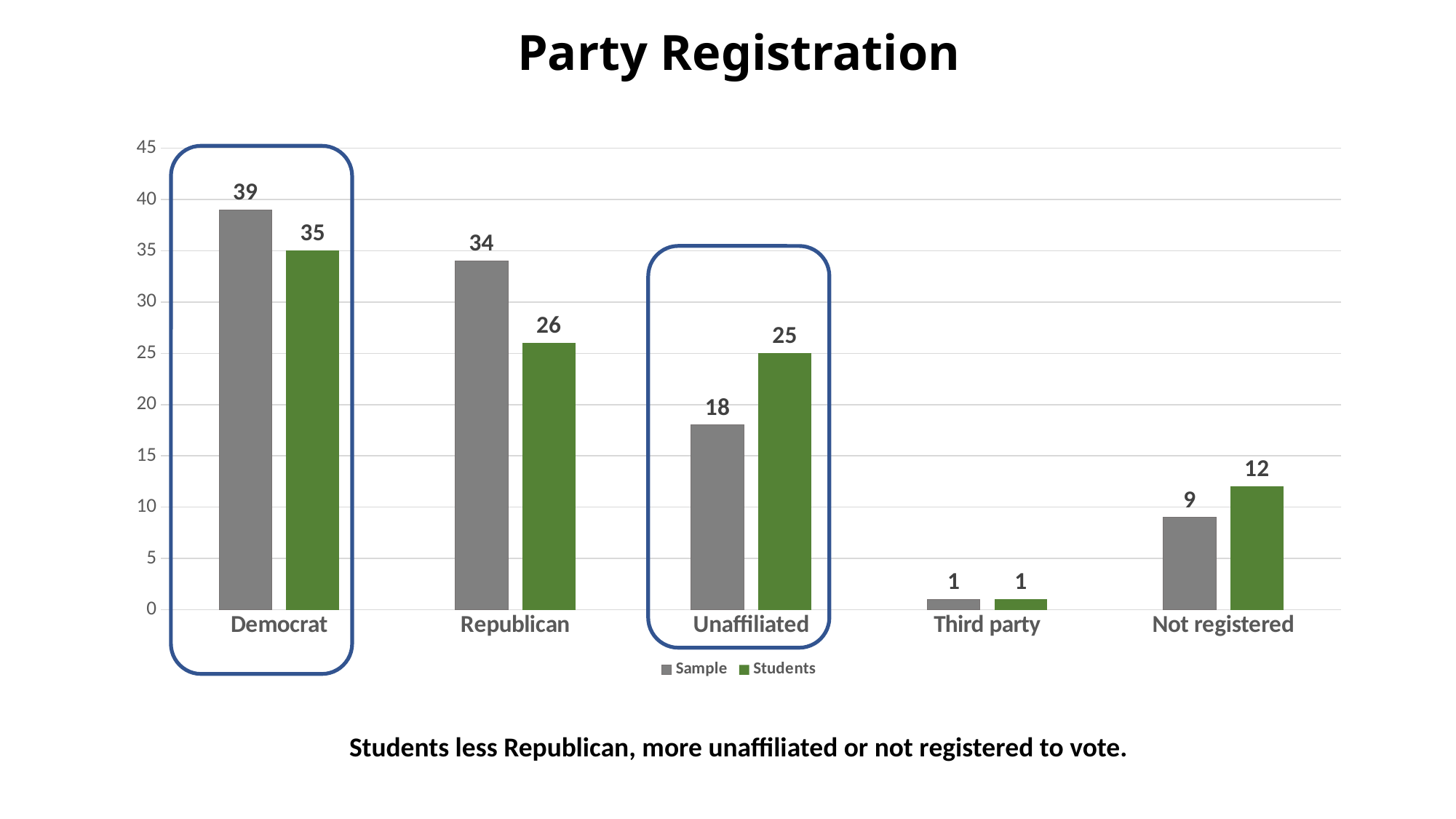
What kind of chart is shown on the slide? Bar chart How many series does the legend list? 2 How many categories are shown on the x axis? 5 What is the difference between the Sample and Students values for Republican? 8 Which category has the highest Sample value? Democrat What is the Students value for Unaffiliated? 25 What is the title of the chart? Party Registration For Unaffiliated, which series has the larger value, Sample or Students? Students Which category has the lowest Students value? Third party Which colour represents the Students series? Green What is the Sample value for Democrat? 39 What is the Students value for Not registered? 12